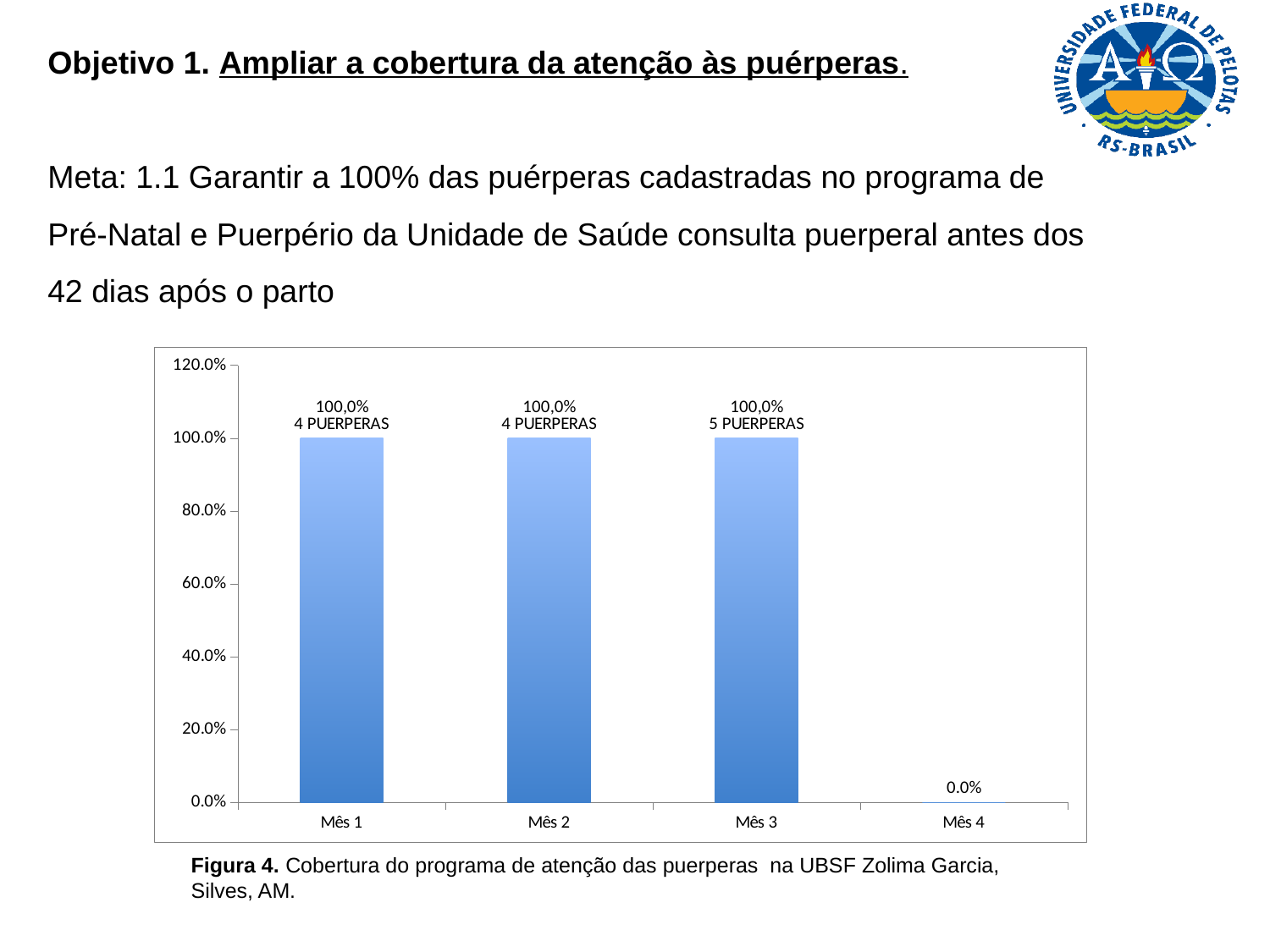
Which is larger, the value for Mês 3 or the value for Mês 4? Mês 3 Is the value for Mês 2 greater or less than 80.0%? greater How many puerperas are indicated in the data label for Mês 2? 4 PUERPERAS What is the value for Mês 4? 0.0% What is the figure number given in the caption below the chart? Figura 4 How many puerperas are indicated in the data label for Mês 3? 5 PUERPERAS Which month has the lowest value? Mês 4 What kind of chart is shown on the slide? Bar chart How many months (categories) are shown on the x axis? 4 Does the value rise or fall from Mês 3 to Mês 4? Fall What is the value for Mês 1? 100,0% Is the value for Mês 4 greater or less than 20.0%? less